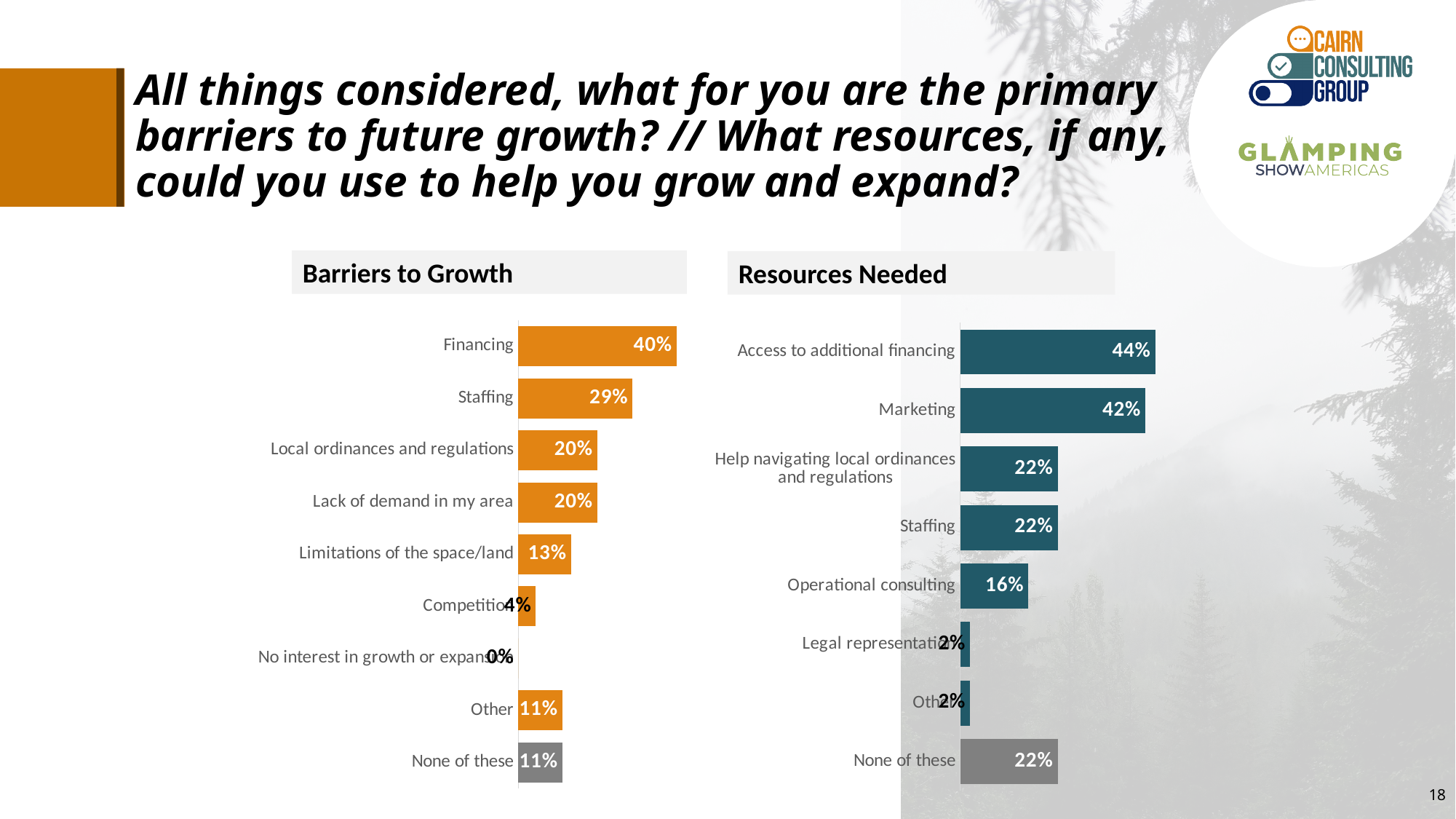
In the Barriers to Growth chart, how many categories are shown? 9 In the Resources Needed chart, what is the value for Marketing? 42% In the Barriers to Growth chart, which category has the highest value? Financing In the Barriers to Growth chart, what is the value for Financing? 40% In the Barriers to Growth chart, what is the difference between Financing and Staffing? 11% In the Resources Needed chart, what is the value for Operational consulting? 16% In the Barriers to Growth chart, what is the value for Staffing? 29% In the Resources Needed chart, which is larger: Staffing or Operational consulting? Staffing In the Resources Needed chart, what is the difference between Access to additional financing and Help navigating local ordinances and regulations? 22% In the Barriers to Growth chart, which category has the lowest value? No interest in growth or expansion What type of chart is the Resources Needed chart? Bar chart In the Resources Needed chart, which category has the highest value? Access to additional financing